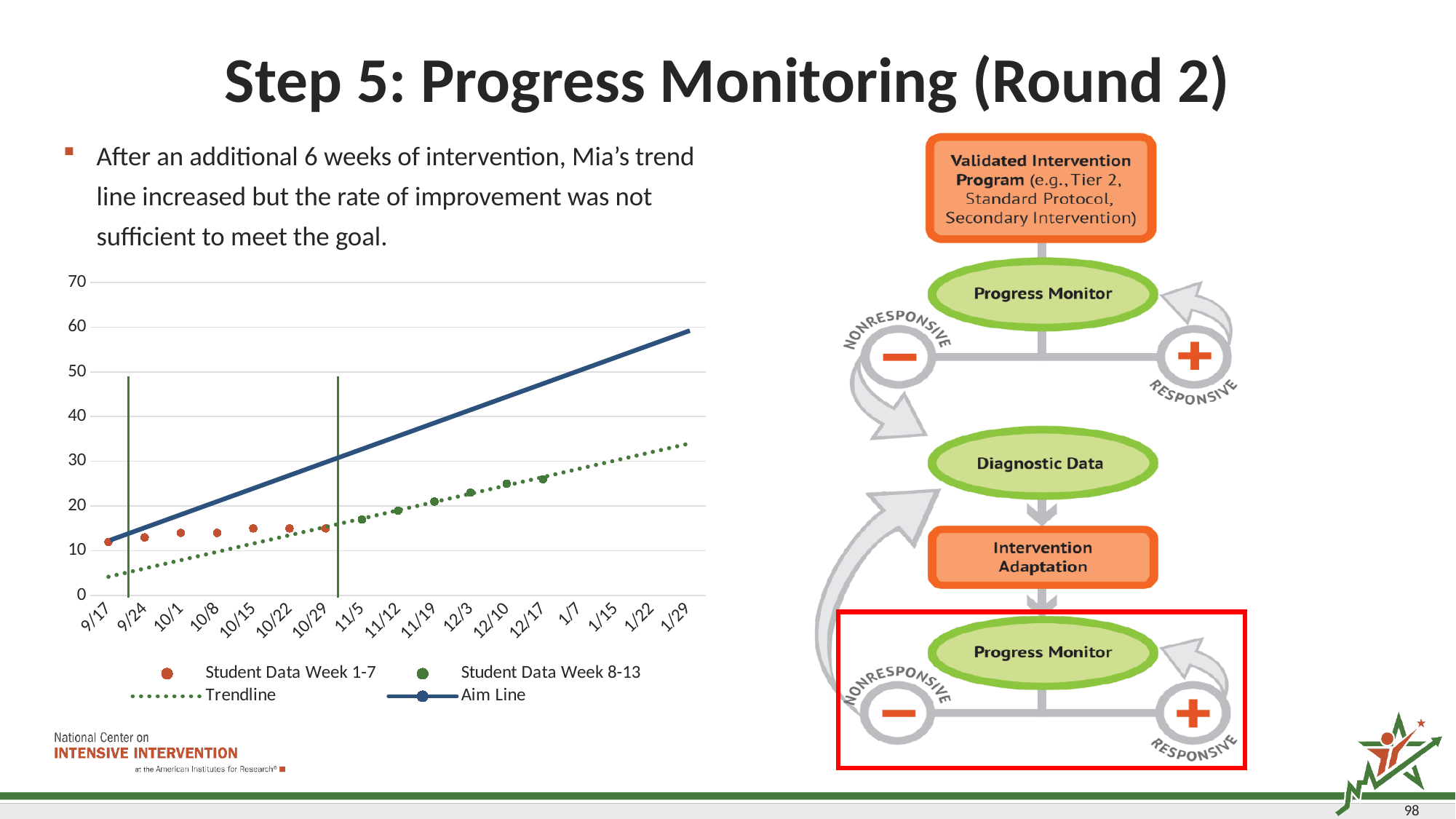
Do the student data points rise or fall from 9/17 to 12/17? Rise What are the four entries in the chart legend? Student Data Week 1-7, Student Data Week 8-13, Trendline, Aim Line Is the Student Data value for 12/17 greater or less than 20? greater What colour is the Aim Line in the chart? Blue How many Student Data Week 1-7 points are plotted on the chart? 7 How many series does the chart legend list? 4 How many Student Data Week 8-13 points are plotted on the chart? 6 Is the Student Data value for 9/17 greater or less than 20? less Is the Aim Line value at 1/29 greater or less than 50? greater What is the highest value shown on the chart's vertical axis? 70 At 12/17, which is higher: the Aim Line or the Student Data point? Aim Line